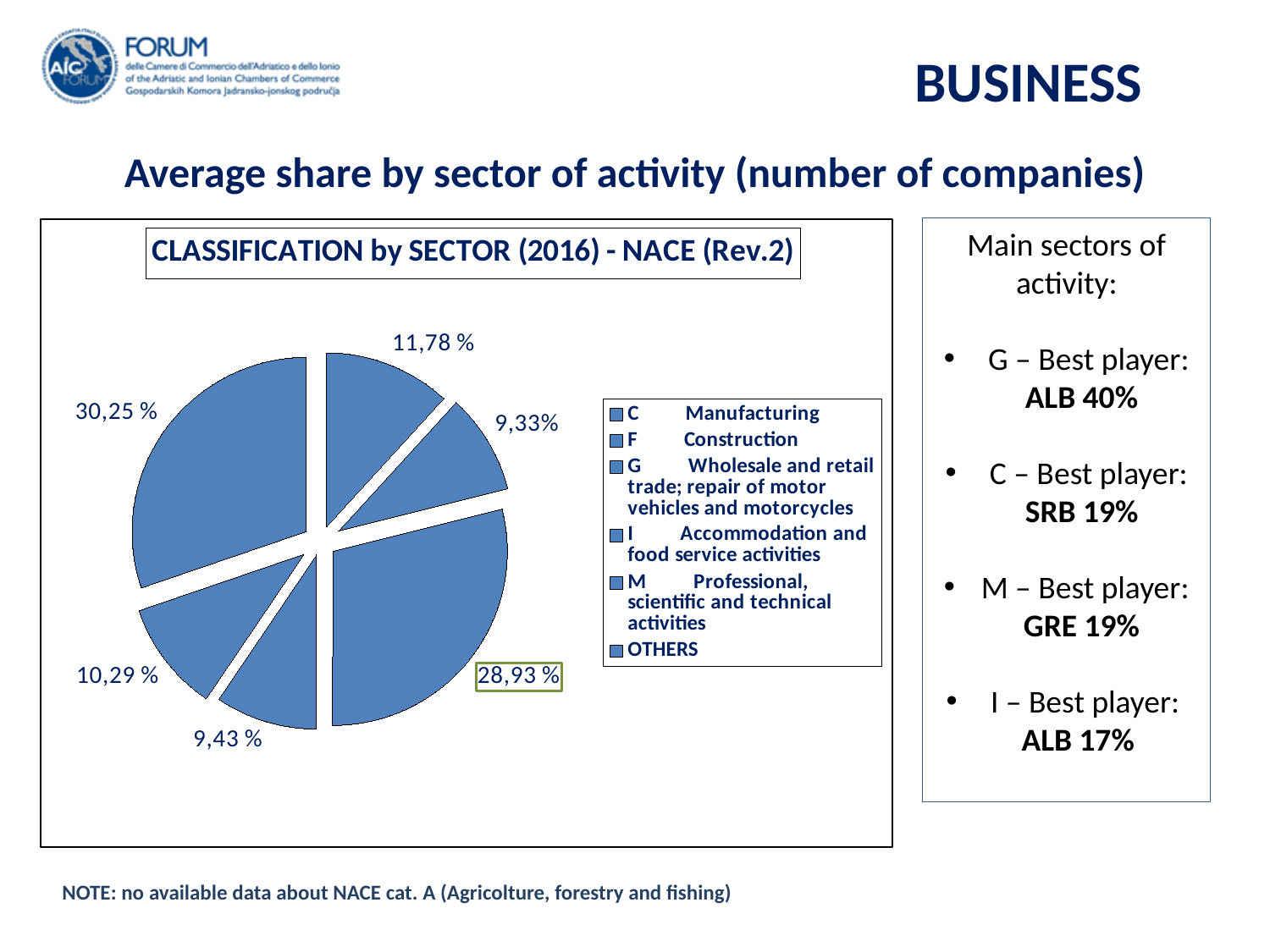
What is the value of the smallest slice in the pie chart? 9,33% Which is larger, the slice labelled 9,43 % or the slice labelled 9,33%? 9,43 % How many entries does the chart legend list? 6 How many slices does the pie chart have? 6 What is the value of the largest slice in the pie chart? 30,25 % What is the title of the chart? CLASSIFICATION by SECTOR (2016) - NACE (Rev.2) What is the difference between the slices labelled 11,78 % and 10,29 %? 1,49 % How many slices in the pie chart have a value below 10%? 2 What kind of chart is shown on the slide? pie chart What is the difference between the two largest slices, 30,25 % and 28,93 %? 1,32 % Which data label on the pie chart is outlined with a green box? 28,93 % What is the combined share of the two largest slices (30,25 % and 28,93 %)? 59,18 %